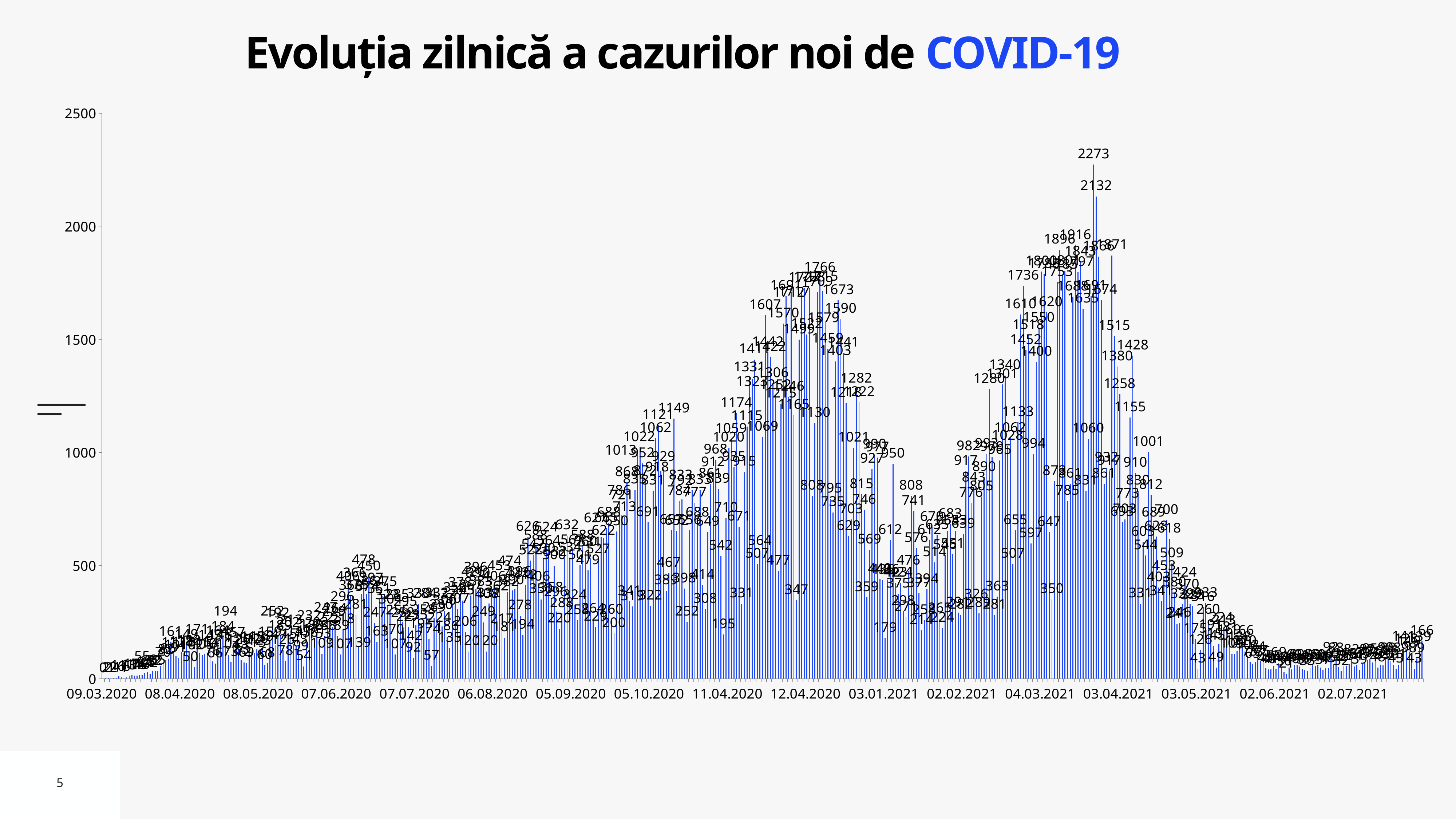
What is the highest value shown on the vertical axis? 2500 What is the difference between the two highest labelled values, 2273 and 2132? 141 What kind of chart is shown on the slide? bar chart What is the second-highest daily value labelled on the chart, next to the 2273 peak? 2132 How many date labels are shown along the horizontal axis? 17 Is the highest bar on the chart greater or less than 2000? greater What is the title of the chart? Evoluția zilnică a cazurilor noi de COVID-19 What is the highest daily value labelled on the chart? 2273 What is the first date label on the horizontal axis? 09.03.2020 Which is larger, the bar labelled 2273 or the bar labelled 2132? 2273 From the peak near 03.04.2021 to 02.06.2021, do the daily values rise or fall? fall Is the peak of the late-2020 wave, labelled 1766, greater or less than 2000? less